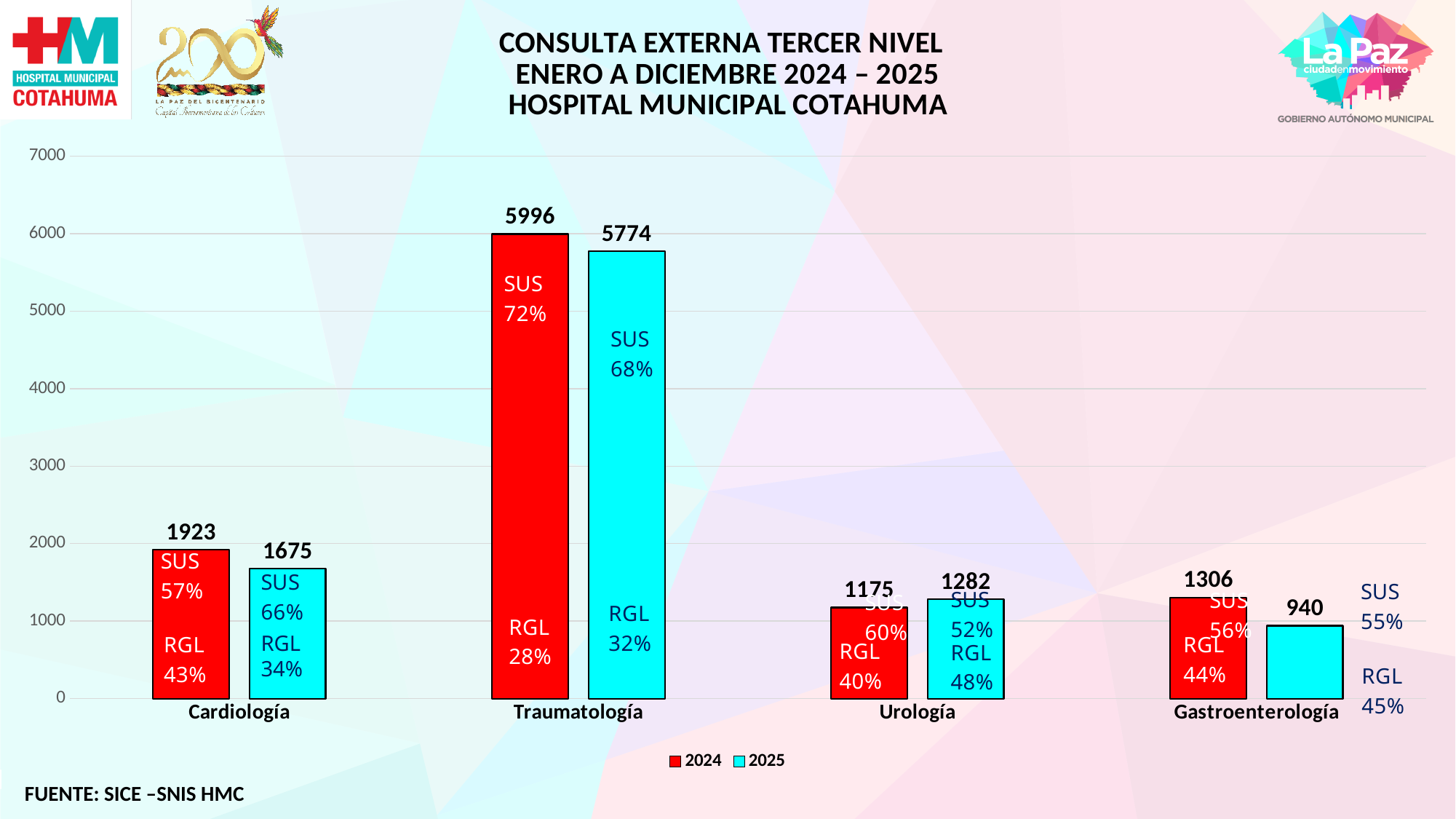
What is the value for Cardiología in 2025? 1675 What is the value for Gastroenterología in 2025? 940 How many categories are shown on the x axis? 4 Which category has the highest value in 2024? Traumatología What kind of chart is shown on the slide? Bar chart What is the difference between the 2024 and 2025 values for Cardiología? 248 What is the value for Urología in 2024? 1175 What is the value for Traumatología in 2024? 5996 How many series does the legend list? 2 Which is larger for Urología, the 2024 value or the 2025 value? 2025 Which category has the lowest value in 2025? Gastroenterología What is the difference between the 2024 and 2025 values for Traumatología? 222